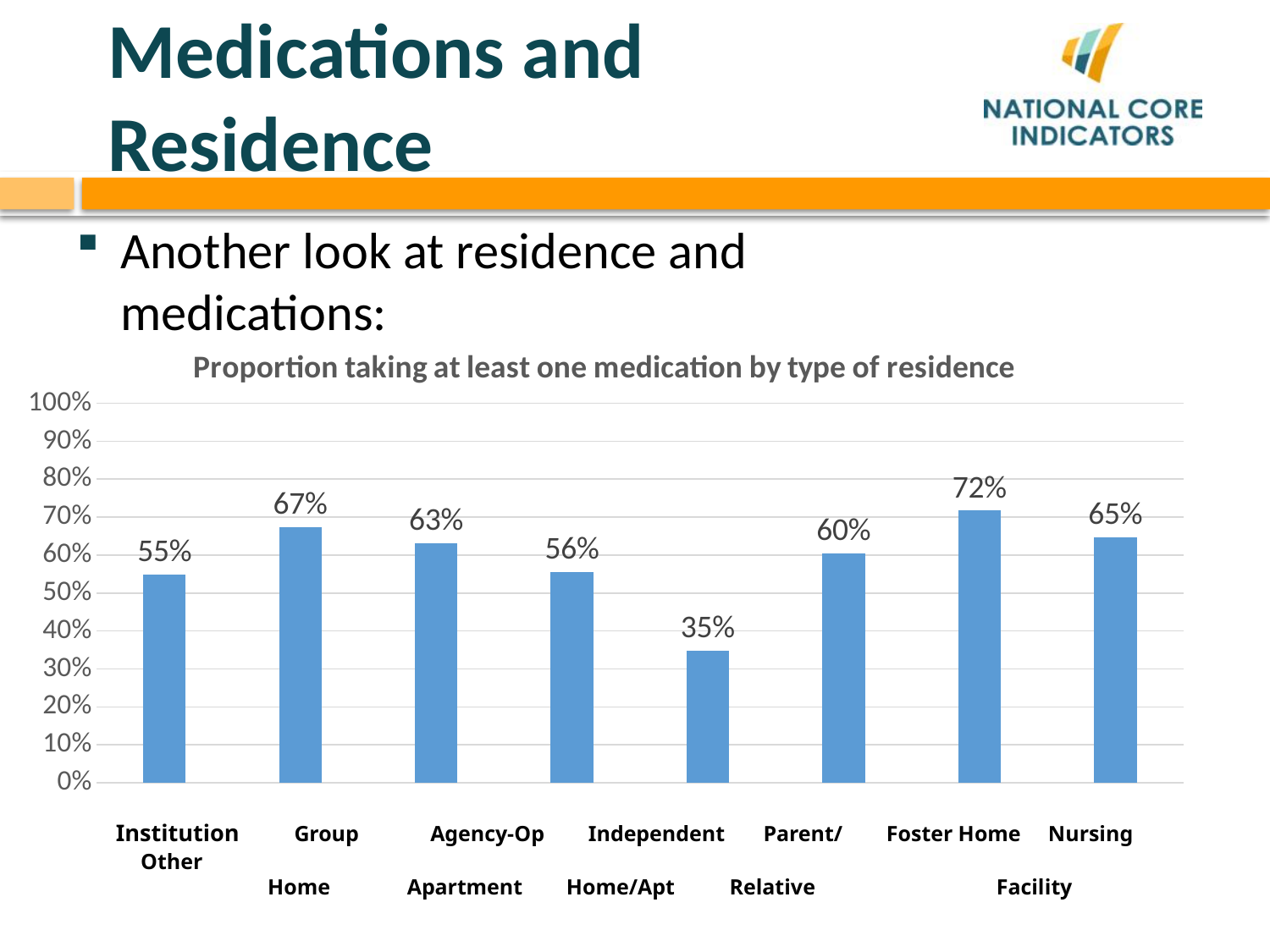
Which type of residence has the lowest proportion taking at least one medication? Parent/Relative What is the value for Independent Home/Apt? 56% How many types of residence are shown in the chart? 8 Is the value for Parent/Relative greater or less than 40%? less What kind of chart is shown on the slide? bar chart What is the difference between the values for Group Home and Agency-Op Apartment? 4% Which is larger, the value for Nursing Facility or the value for Parent/Relative? Nursing Facility What is the value for Institution Other? 55% What is the title of the chart? Proportion taking at least one medication by type of residence